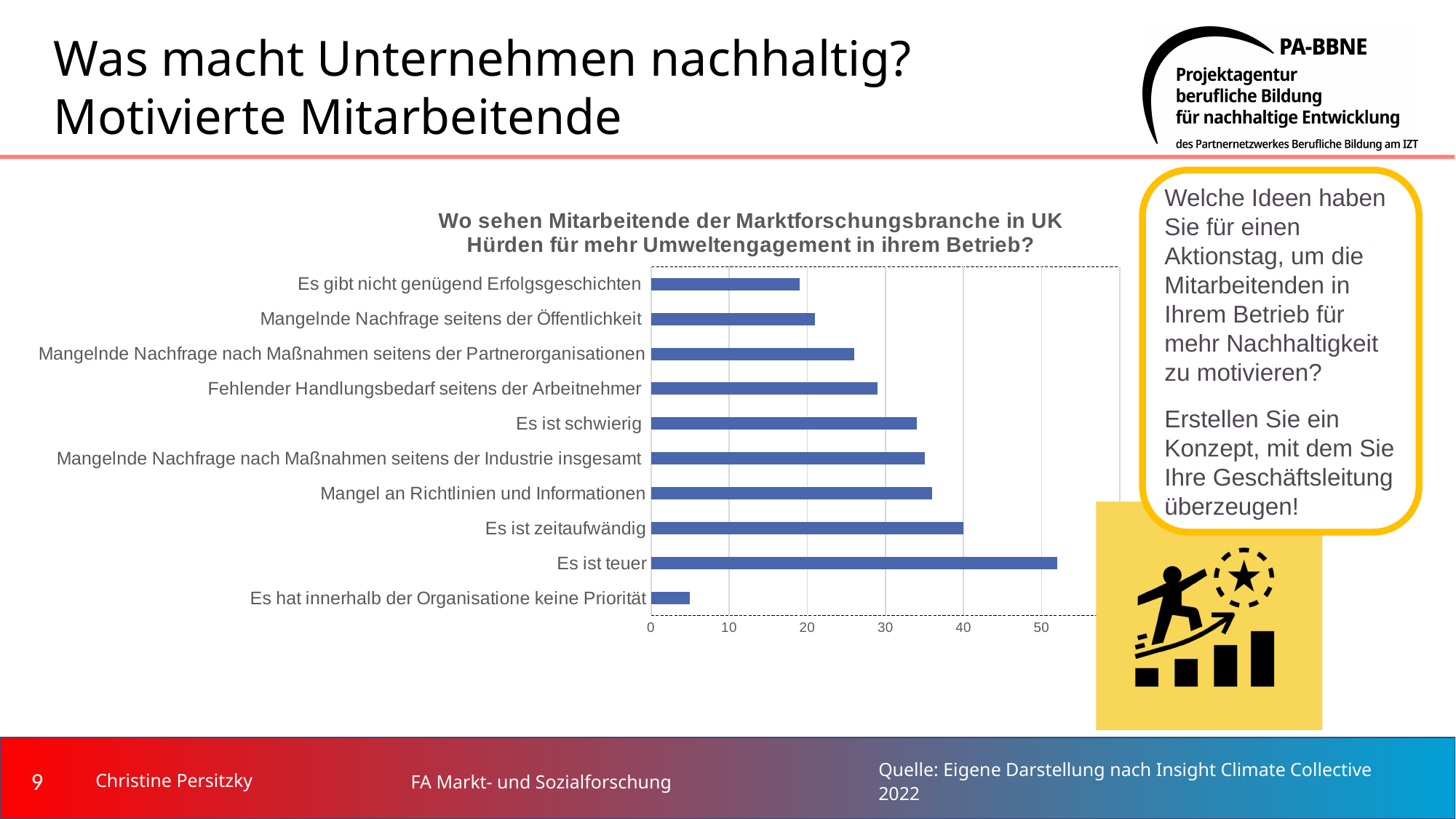
Which is larger: the value for "Es ist schwierig" or the value for "Mangelnde Nachfrage seitens der Öffentlichkeit"? Es ist schwierig Is the value for "Mangelnde Nachfrage nach Maßnahmen seitens der Partnerorganisationen" greater or less than 20? greater What is the title of the chart? Wo sehen Mitarbeitende der Marktforschungsbranche in UK Hürden für mehr Umweltengagement in ihrem Betrieb? What kind of chart is shown on the slide? bar chart Which is larger: the value for "Es ist teuer" or the value for "Es ist zeitaufwändig"? Es ist teuer Is the value for "Es ist teuer" greater or less than 50? greater Is the value for "Es hat innerhalb der Organisatione keine Priorität" greater or less than 10? less How many categories are shown in the chart? 10 Which category has the lowest value in the chart? Es hat innerhalb der Organisatione keine Priorität Which category has the highest value in the chart? Es ist teuer